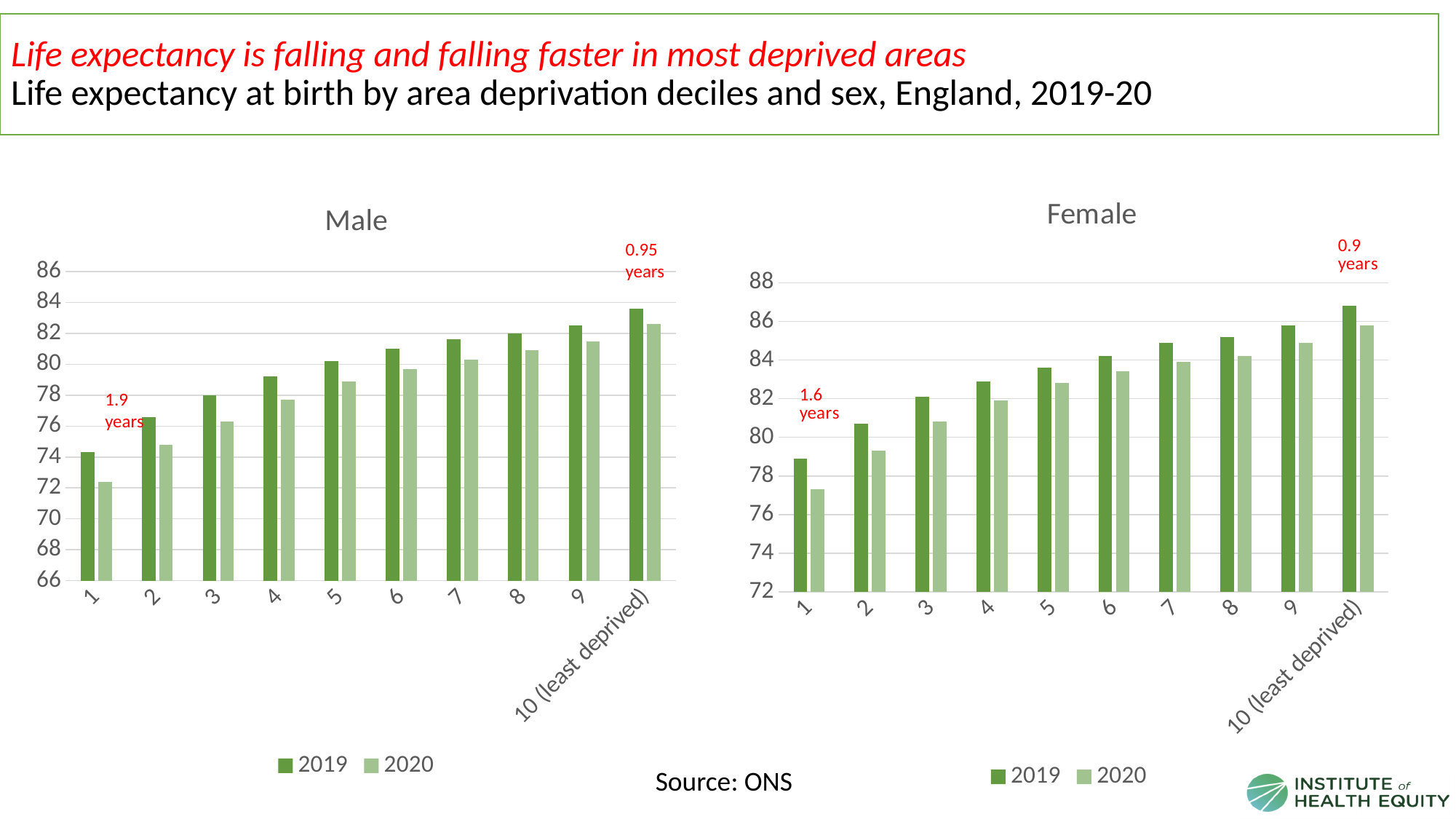
In the Male chart, which decile has the highest 2019 life expectancy? 10 (least deprived) How many series does the legend of the Male chart list? 2 In the Female chart, do life expectancy values rise or fall as the deciles go from 1 to 10? rise In the Male chart, what gap in years is annotated above decile 10 (least deprived)? 0.95 years In the Female chart, what gap in years is annotated above decile 10 (least deprived)? 0.9 years How many deprivation deciles are shown on the x axis of the Female chart? 10 In the Female chart, which decile has the lowest 2020 life expectancy? 1 In the Female chart, what gap in years is annotated above decile 1? 1.6 years In the Female chart, is the 2019 value for decile 10 (least deprived) greater or less than 86? greater In the Male chart, is the 2020 value for decile 1 greater or less than 74? less What type of chart is used for the Male chart? bar chart In the Male chart, what gap in years is annotated above decile 1? 1.9 years